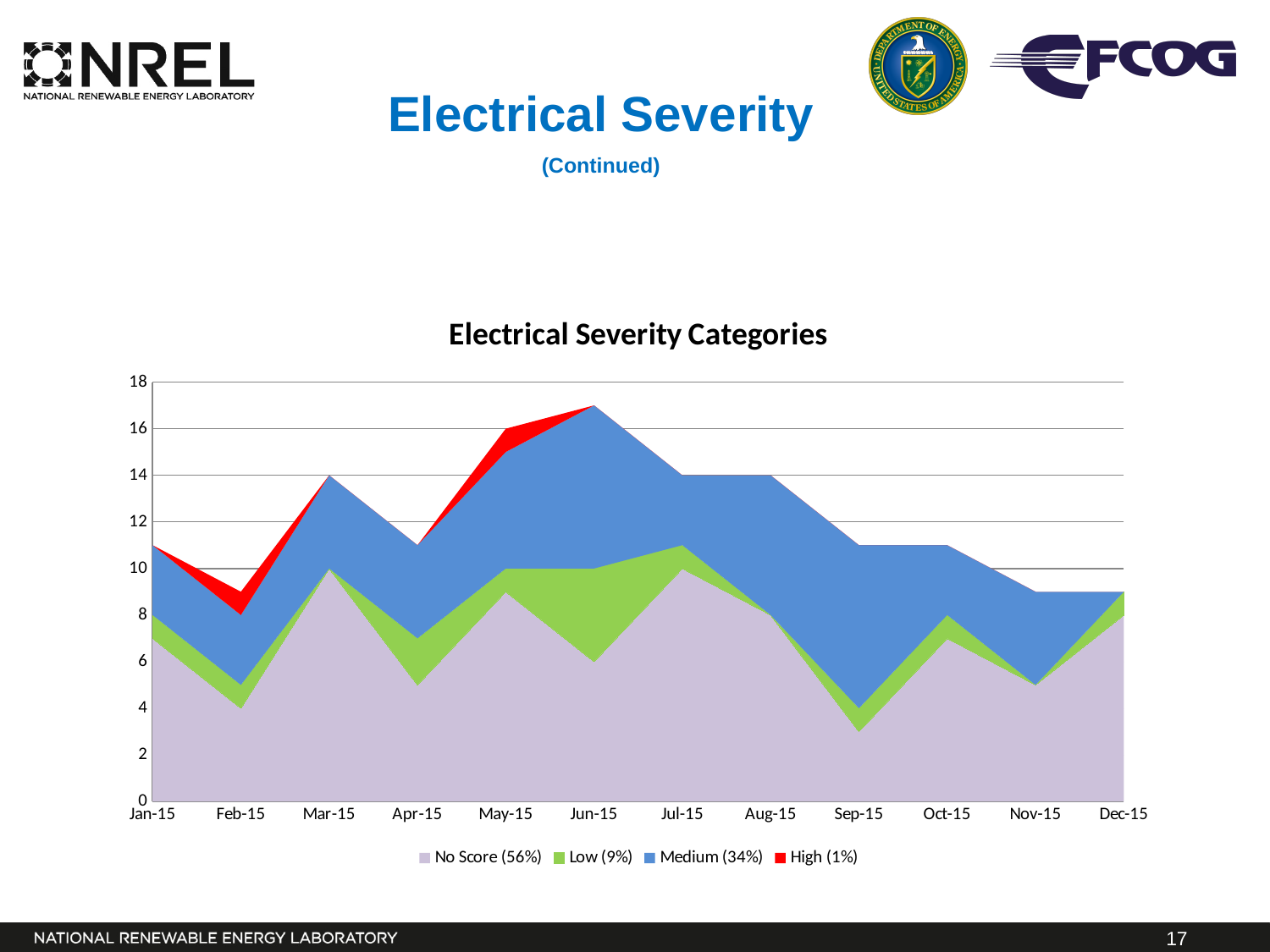
How many months are shown along the x axis? 12 How many series does the legend list? 4 What is the total value across all categories for Mar-15? 14 Which month has the larger total, Mar-15 or Apr-15? Mar-15 Does the total value rise or fall from Aug-15 to Dec-15? Fall Is the total value for Jan-15 greater or less than 10? greater Which month has the highest total across all categories? Jun-15 Which month has the lowest No Score value? Sep-15 What percentage is shown in the legend for the Medium category? 34% Is the total value for Jun-15 greater or less than 16? greater What kind of chart is shown on the slide? Stacked area chart Is the No Score value for Sep-15 greater or less than 4? less